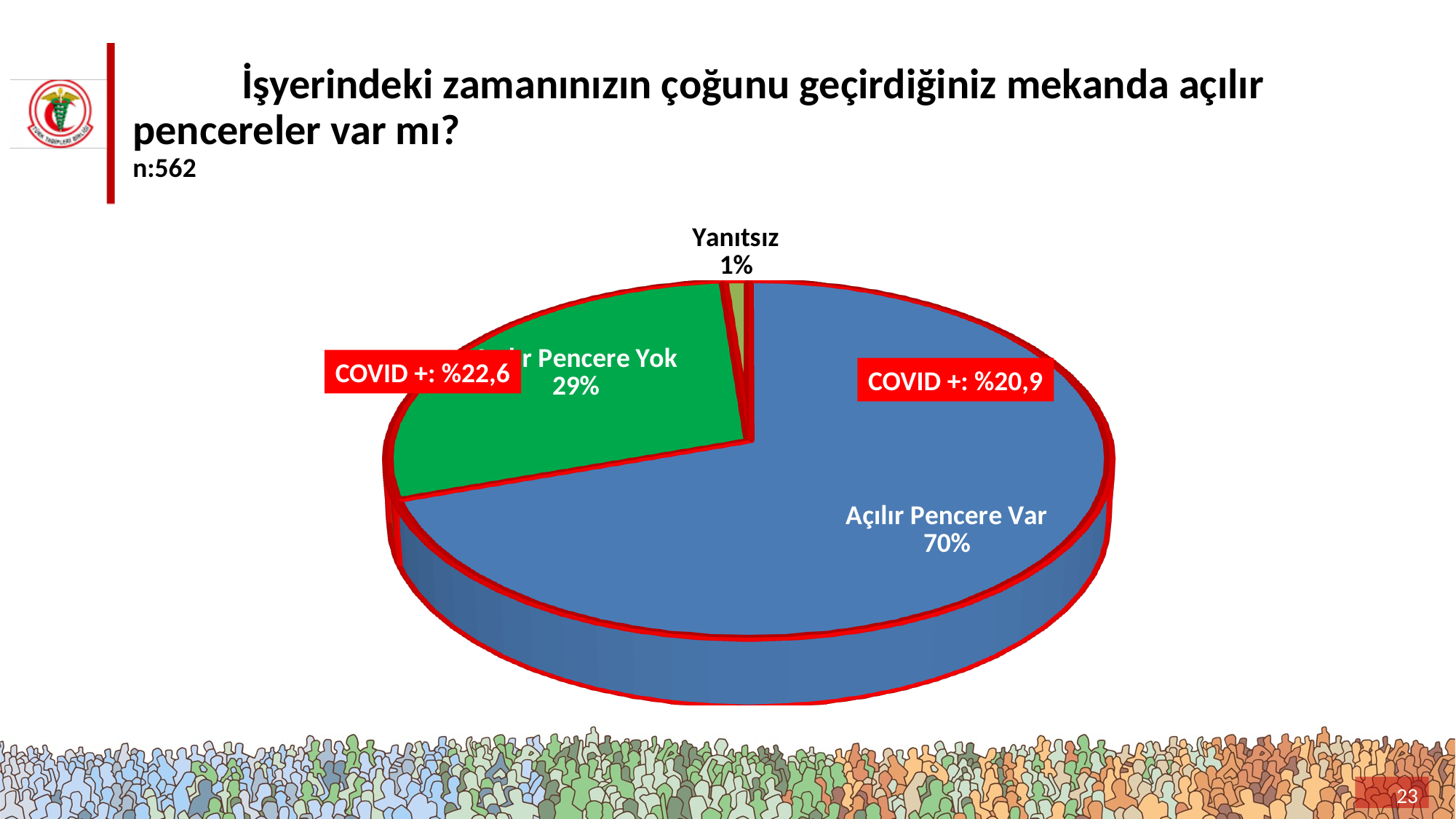
What is the difference in percentage points between the "Açılır Pencere Var" and "Açılır Pencere Yok" slices? 41 How many slices does the pie chart have? 3 What share of the pie is labelled "Yanıtsız"? 1% Which slice of the pie is the smallest? Yanıtsız What kind of chart is shown on the slide? pie chart Which slice of the pie is the largest? Açılır Pencere Var Which is larger, the "Açılır Pencere Yok" slice or the "Yanıtsız" slice? Açılır Pencere Yok What share of the pie is labelled "Açılır Pencere Var"? 70% What COVID + percentage is shown in the red box next to the "Açılır Pencere Var" slice? %20,9 What sample size (n) is stated on the slide? 562 What COVID + percentage is shown in the red box next to the "Açılır Pencere Yok" slice? %22,6 What share of the pie is labelled "Açılır Pencere Yok"? 29%